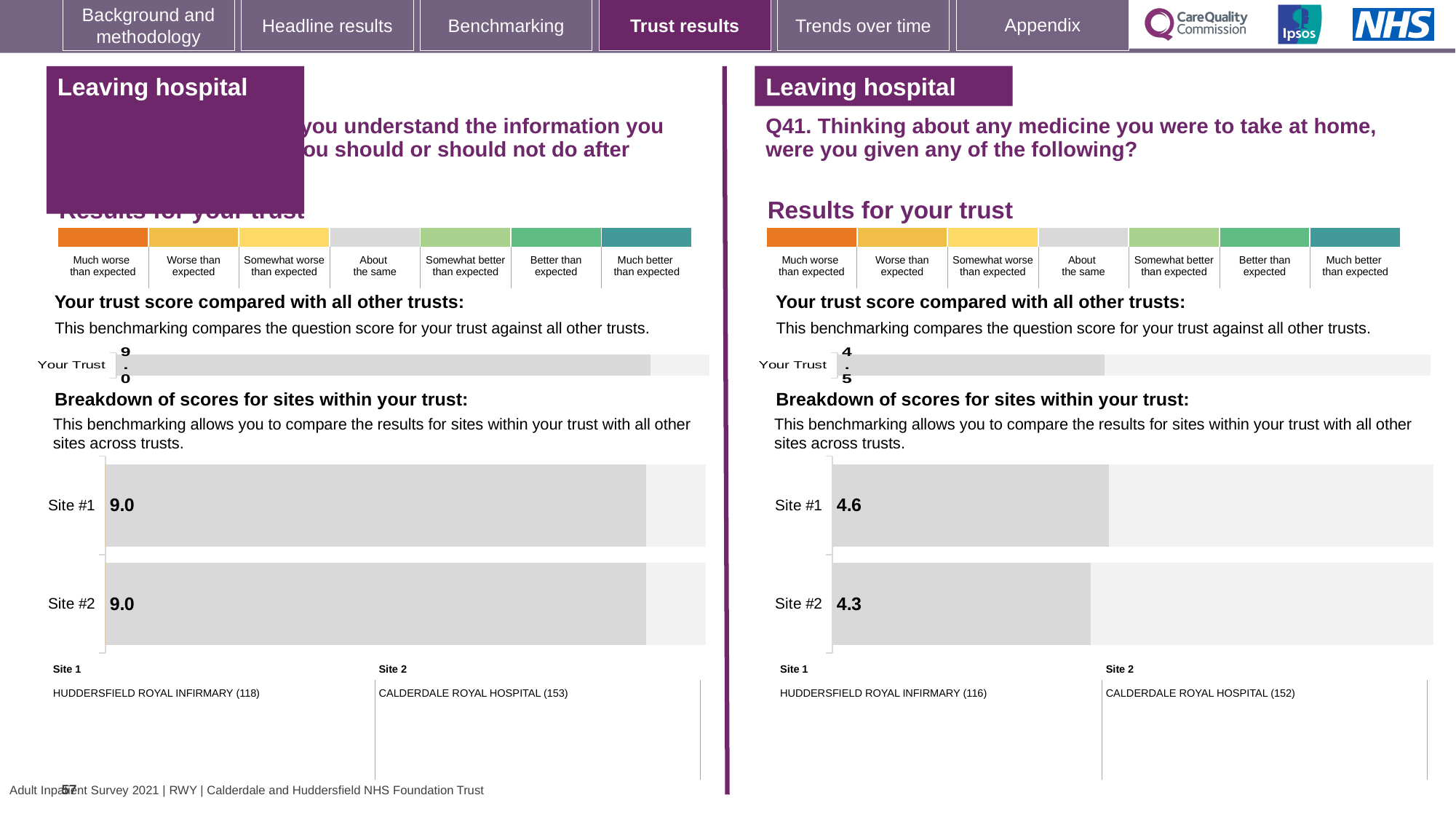
On the left-hand site breakdown chart, what is the score for Site #1? 9.0 On the right-hand site breakdown chart for Q41, is the Site #1 score larger or smaller than the Your Trust score of 4.5? Larger On the right-hand chart for Q41, what is the score for Site #2? 4.3 On the right-hand site breakdown chart for Q41, what is the difference between the Site #1 and Site #2 scores? 0.3 On the left-hand 'Your trust score compared with all other trusts' chart, what is the value for Your Trust? 9.0 On the right-hand 'Your trust score compared with all other trusts' chart for Q41, what is the value for Your Trust? 4.5 On the right-hand site breakdown chart for Q41, how many sites are shown? 2 On the right-hand chart for Q41, what is the score for Site #1? 4.6 On the right-hand site breakdown chart for Q41, which site has the higher score? Site #1 What kind of chart is the site breakdown chart on the left-hand side of the slide? Bar chart On the right-hand site breakdown chart for Q41, which site has the lower score? Site #2 On the left-hand site breakdown chart, what is the score for Site #2? 9.0